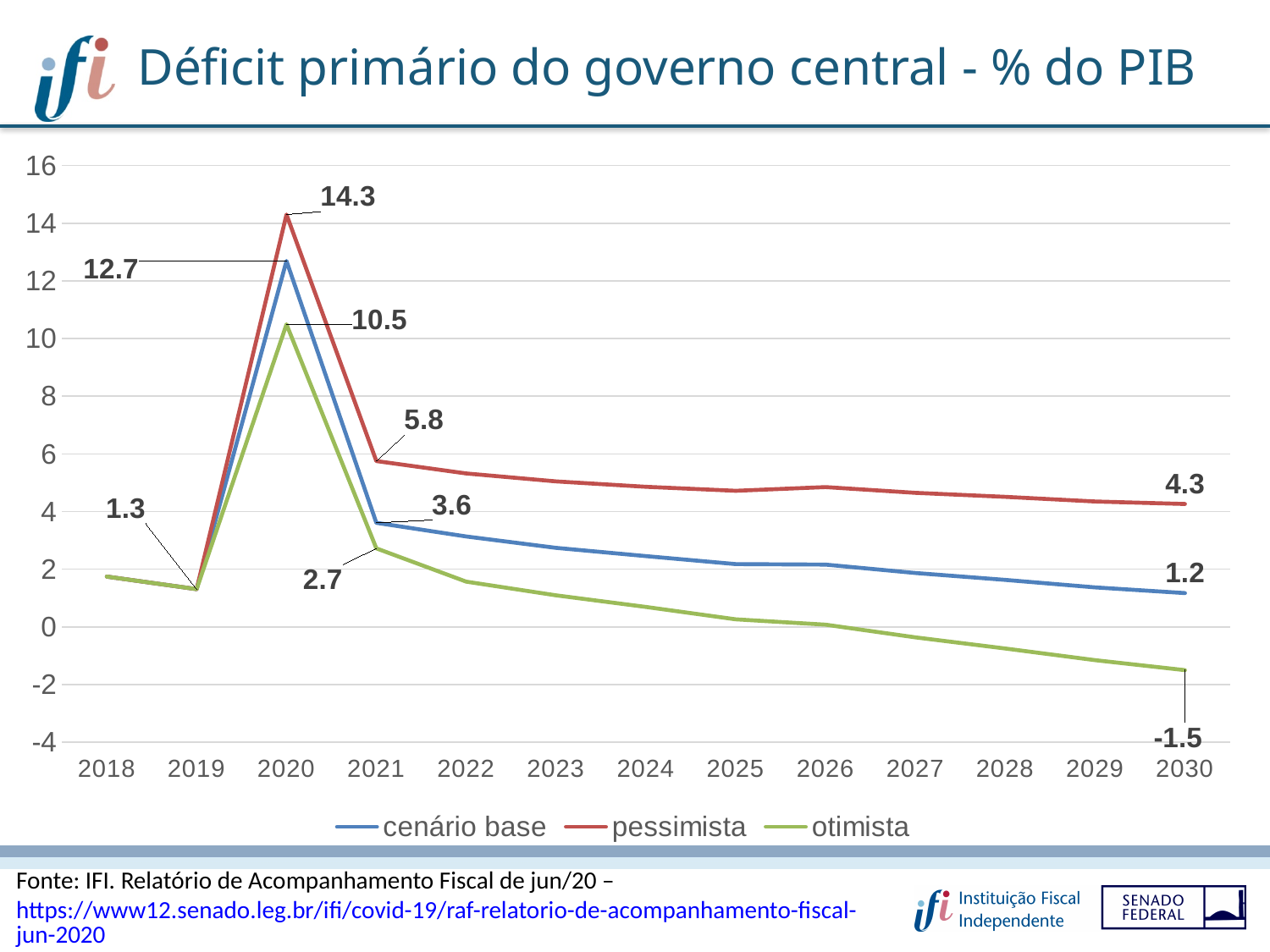
What is the value shown for 2019? 1.3 Is the value for pessimista in 2025 greater or less than 6? less What is the difference between the pessimista and cenário base values in 2030? 3.1 What is the value of the pessimista series in 2020? 14.3 What is the value of the cenário base series in 2020? 12.7 How many series does the legend list? 3 What is the value of the otimista series in 2030? -1.5 What is the difference between the pessimista and cenário base values in 2020? 1.6 In 2021, which is larger: the cenário base value or the otimista value? cenário base Which series has the highest value in 2020? pessimista What kind of chart is shown on the slide? line chart How many years are shown on the x axis? 13